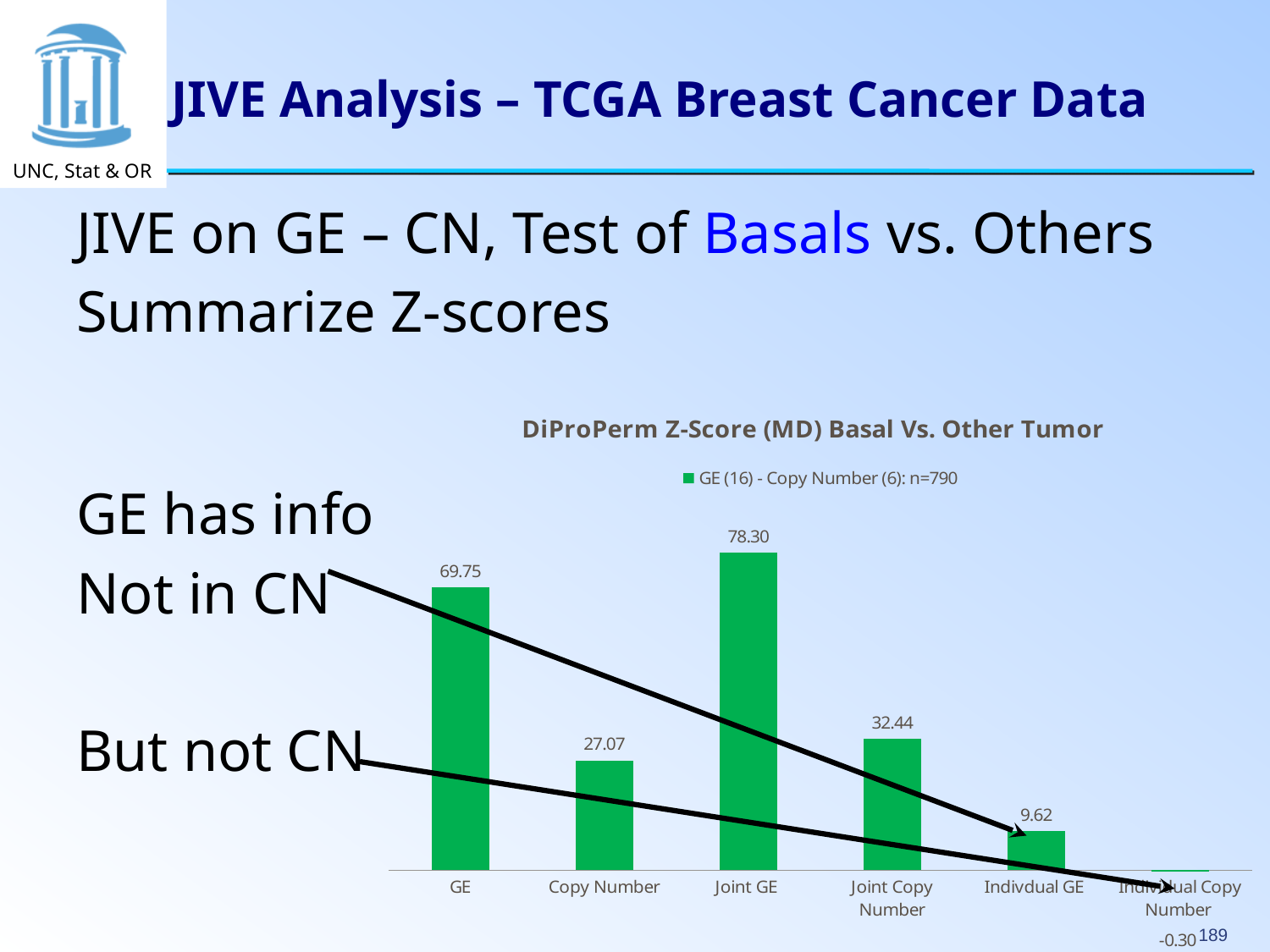
What type of chart is shown on the slide? bar chart Which category has the highest Z-score? Joint GE What is the Z-score value for Copy Number? 27.07 Which category has the lowest Z-score? Individual Copy Number What is the difference between the Z-scores for Joint GE and GE? 8.55 What is the Z-score value for GE? 69.75 How many categories are shown on the x axis? 6 What is the Z-score value for Joint GE? 78.30 What is the title of the chart? DiProPerm Z-Score (MD) Basal Vs. Other Tumor What is the Z-score value for Indivdual GE? 9.62 Which has a larger Z-score, Copy Number or Joint Copy Number? Joint Copy Number What is the Z-score value for Joint Copy Number? 32.44